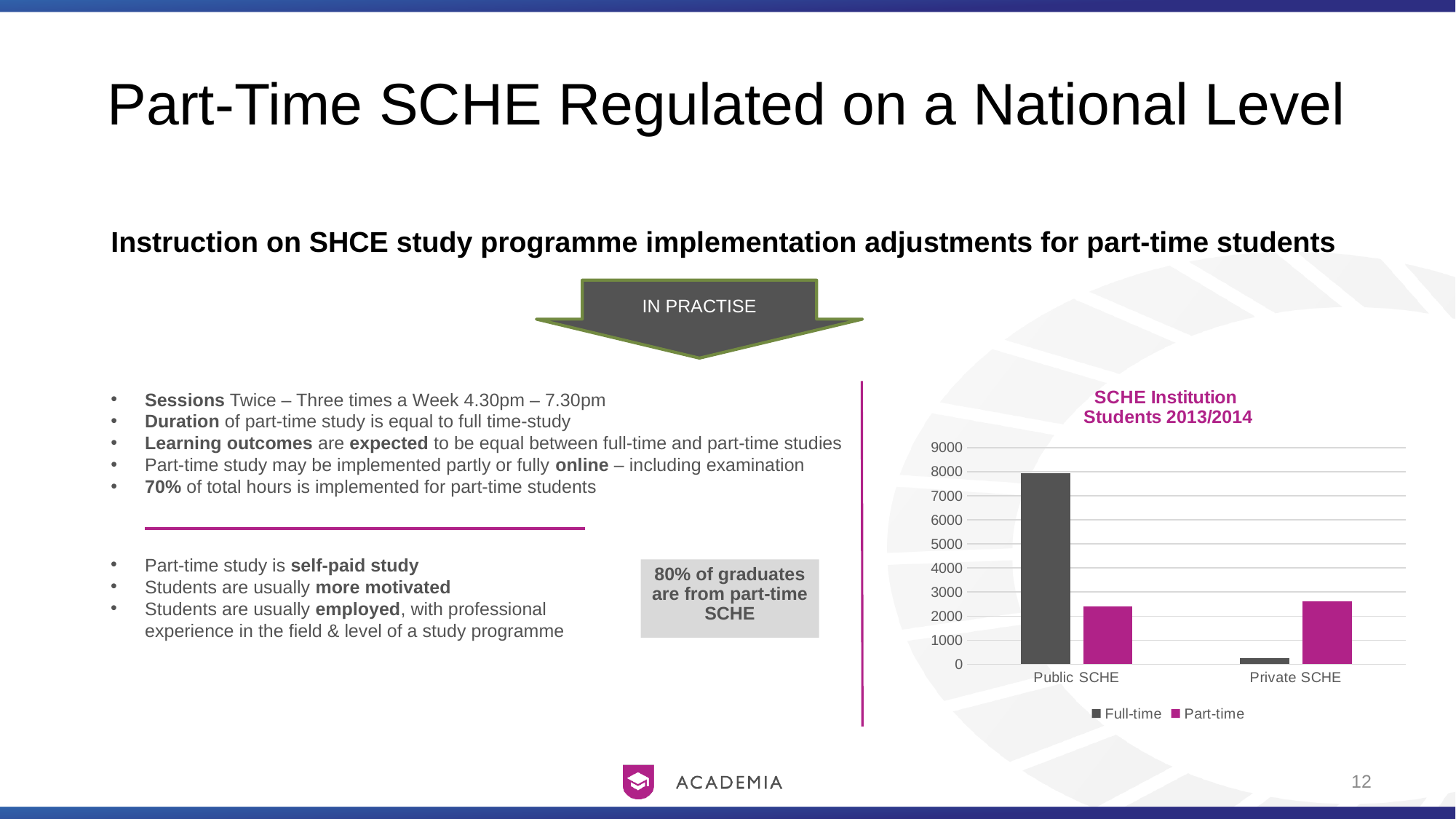
How many categories are shown on the x axis of the chart? 2 How many series does the chart's legend list? 2 Is the Part-time value for Private SCHE greater or less than 2000? greater For Public SCHE, which is larger: the Full-time or the Part-time value? Full-time Is the Full-time value for Private SCHE greater or less than 1000? less Is the Full-time value for Public SCHE greater or less than 7000? greater For Private SCHE, which is larger: the Full-time or the Part-time value? Part-time What kind of chart is shown on the slide? bar chart Which series is shown in magenta in the chart? Part-time What is the title of the chart on the slide? SCHE Institution Students 2013/2014 Which category has the highest Full-time value in the chart? Public SCHE